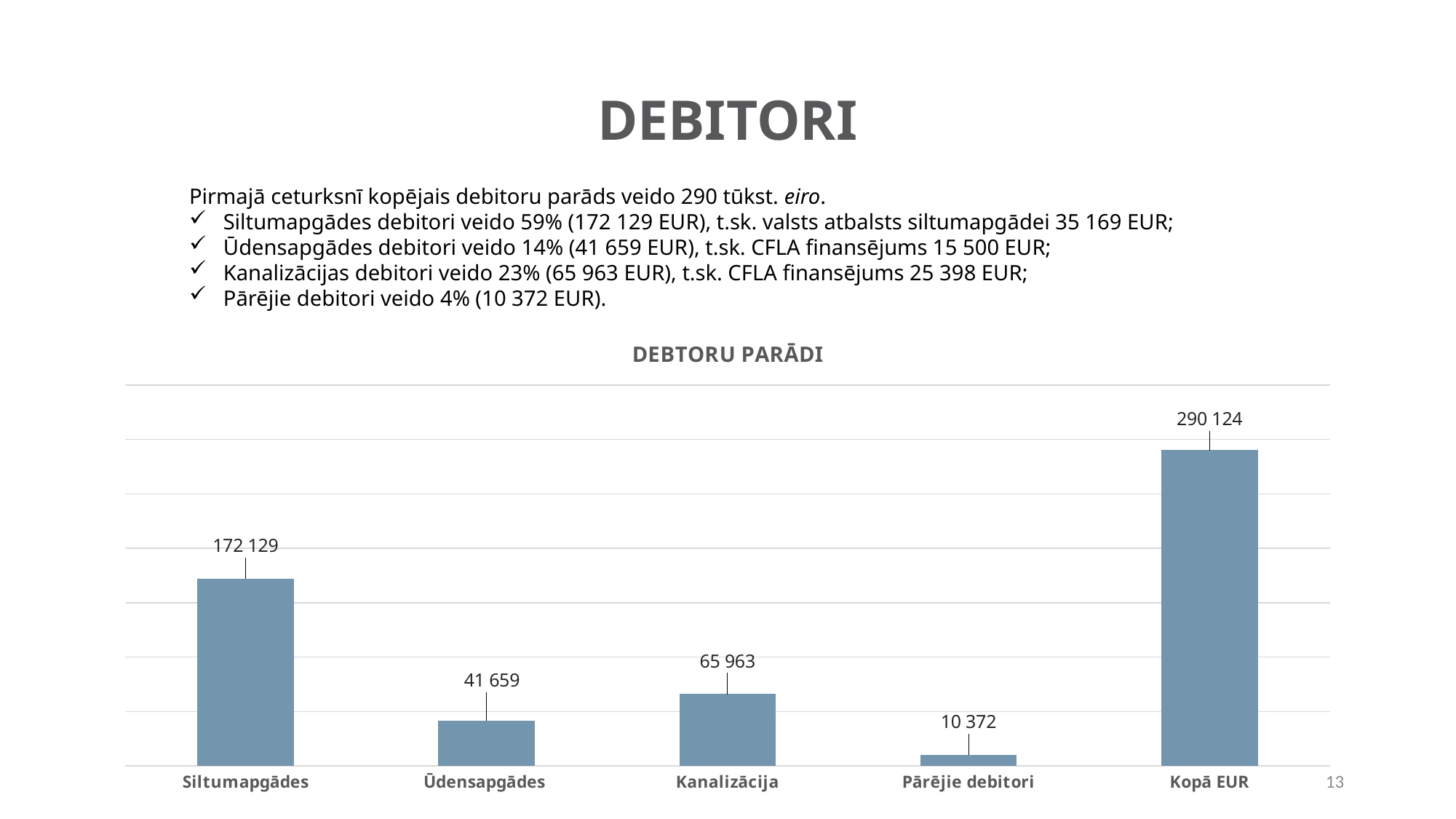
What is the difference between the values for Kanalizācija and Ūdensapgādes in the DEBTORU PARĀDI chart? 24 304 Which category has the lowest value in the DEBTORU PARĀDI chart? Pārējie debitori What is the title of the chart on the slide? DEBTORU PARĀDI How many categories are shown in the DEBTORU PARĀDI chart? 5 Which category has the highest value in the DEBTORU PARĀDI chart? Kopā EUR What type of chart is DEBTORU PARĀDI? Bar chart What is the value for Kanalizācija in the DEBTORU PARĀDI chart? 65 963 What is the value for Pārējie debitori in the DEBTORU PARĀDI chart? 10 372 What is the value for Ūdensapgādes in the DEBTORU PARĀDI chart? 41 659 Which is larger in the DEBTORU PARĀDI chart, Siltumapgādes or Kanalizācija? Siltumapgādes What is the value for Siltumapgādes in the DEBTORU PARĀDI chart? 172 129 What is the value for Kopā EUR in the DEBTORU PARĀDI chart? 290 124